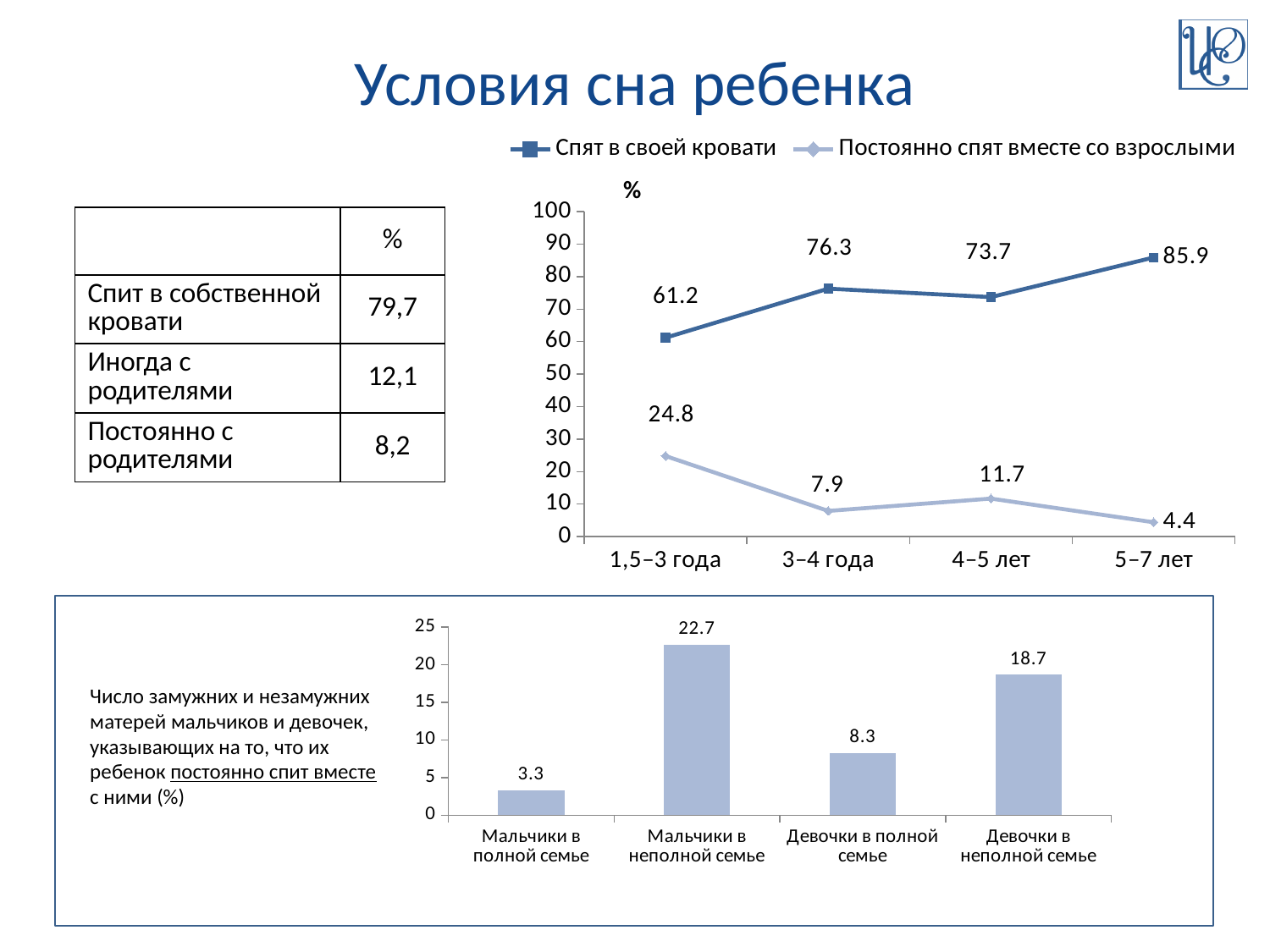
In the line chart at the top of the slide, what is the value for 'Спят в своей кровати' at '5–7 лет'? 85.9 In the bar chart at the bottom of the slide, what is the value for 'Мальчики в неполной семье'? 22.7 In the bar chart at the bottom of the slide, what is the difference between 'Мальчики в неполной семье' and 'Девочки в неполной семье'? 4.0 In the line chart at the top of the slide, which age group has the highest value for 'Спят в своей кровати'? 5–7 лет In the bar chart at the bottom of the slide, which category has the lowest value? Мальчики в полной семье In the line chart at the top of the slide, what is the difference between the 'Спят в своей кровати' values at '3–4 года' and '1,5–3 года'? 15.1 In the line chart at the top of the slide, which age group has the lowest value for 'Постоянно спят вместе со взрослыми'? 5–7 лет How many series does the legend of the line chart at the top of the slide list? 2 In the line chart at the top of the slide, what is the value for 'Постоянно спят вместе со взрослыми' at '1,5–3 года'? 24.8 In the bar chart at the bottom of the slide, which is larger: 'Девочки в полной семье' or 'Девочки в неполной семье'? Девочки в неполной семье How many age groups are shown on the x axis of the line chart at the top of the slide? 4 What type of chart is shown at the bottom of the slide? Bar chart